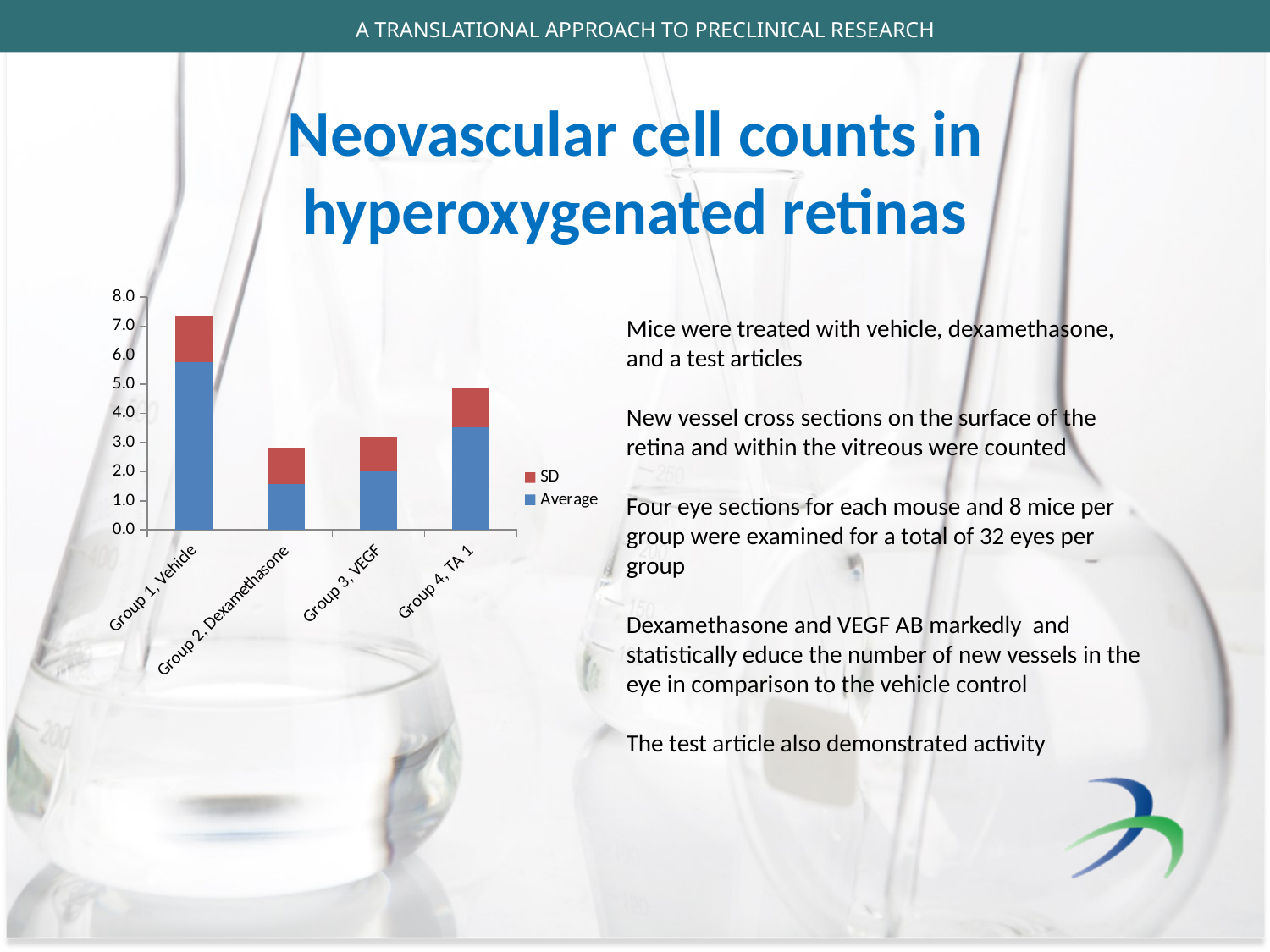
Which group has a taller total stacked bar, Group 1, Vehicle or Group 4, TA 1? Group 1, Vehicle How many series does the chart legend list? 2 What kind of chart is shown on the slide? stacked bar chart Is the Average value for Group 2, Dexamethasone greater or less than 2.0? less Is the Average value for Group 1, Vehicle greater or less than 5.0? greater Which group has the highest Average value in the chart? Group 1, Vehicle Which group has a larger Average value, Group 3, VEGF or Group 4, TA 1? Group 4, TA 1 Which group has the lowest Average value in the chart? Group 2, Dexamethasone How many groups are plotted on the x axis of the chart? 4 Is the Average value for Group 4, TA 1 greater or less than 3.0? greater Which series is shown in red in the chart legend? SD Which series is shown in blue in the chart legend? Average